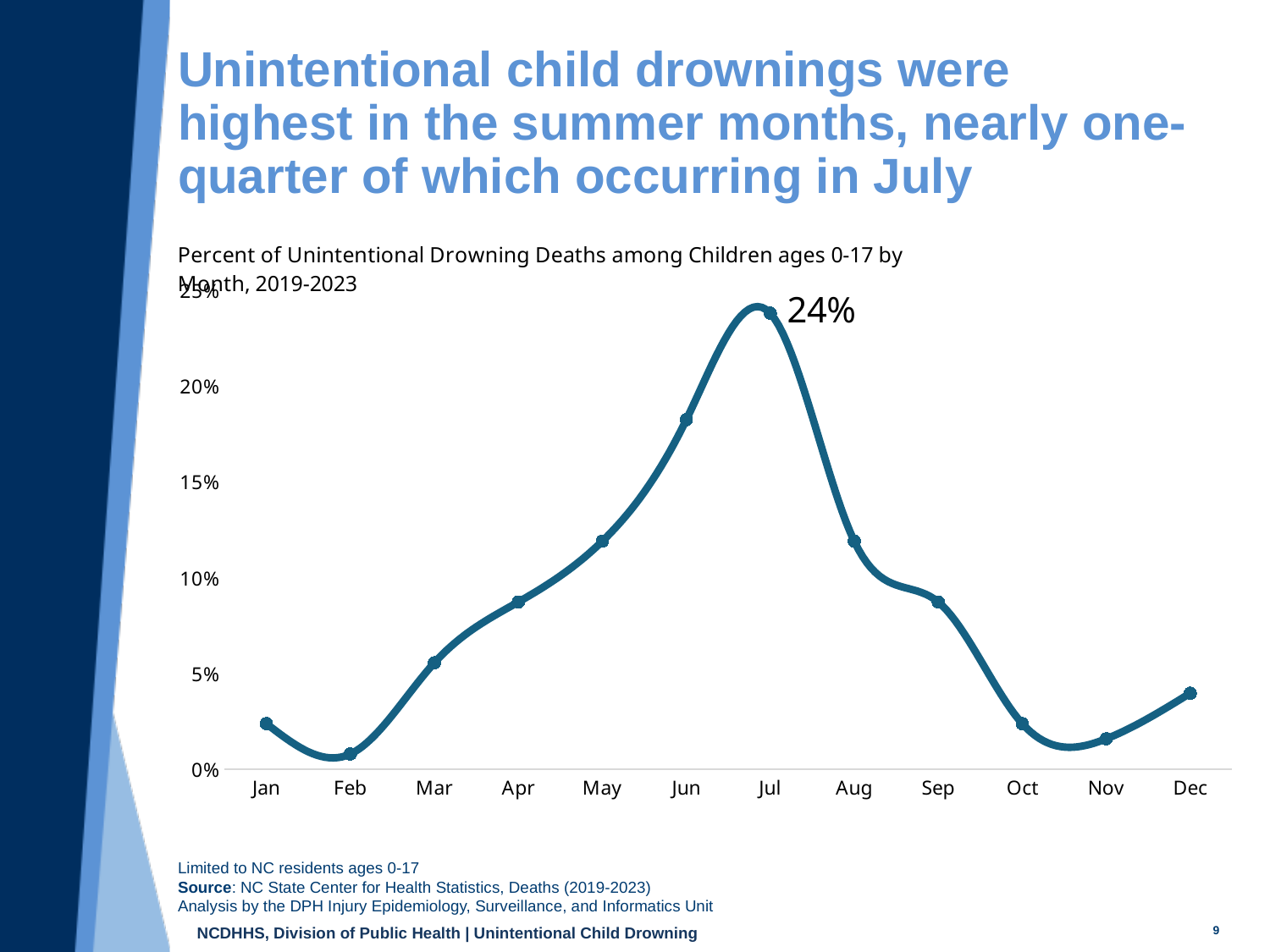
Is the value for Jun greater or less than 15%? greater Is the value for Aug greater or less than 10%? greater Which is larger, the value for May or the value for Sep? May Which is larger, the value for Jun or the value for Aug? Jun Which month has the lowest percent of unintentional drowning deaths? Feb Is the value for Feb greater or less than 5%? less What is the value for Jul? 24% Which month has the highest percent of unintentional drowning deaths? Jul Do the values rise or fall from Feb to Jul? Rise What kind of chart is shown on the slide? Line chart How many months are plotted on the x axis? 12